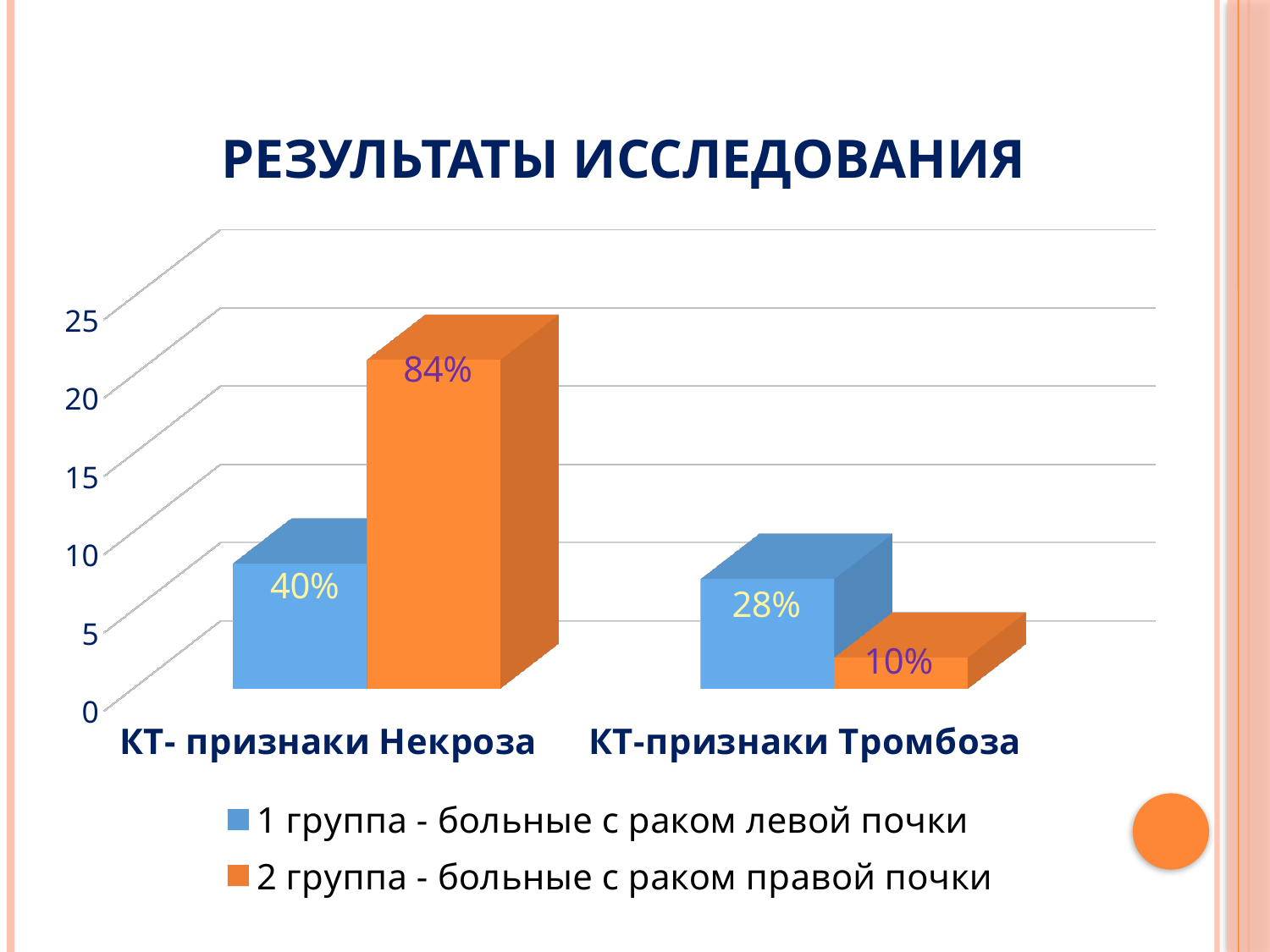
What is the difference between the data labels of group 1 and group 2 in the category 'КТ-признаки Тромбоза'? 18% In the category 'КТ-признаки Тромбоза', which group has the larger value? 1 группа - больные с раком левой почки How many series does the legend list? 2 What type of chart is shown on the slide? Bar chart Which bar has the lowest data label on the chart? Group 2 (больные с раком правой почки), КТ-признаки Тромбоза What is the data label for group 1 in the category 'КТ-признаки Тромбоза'? 28% Is the bar for group 2 in 'КТ- признаки Некроза' greater or less than 15 on the vertical axis? greater What is the data label for group 1 (больные с раком левой почки) in the category 'КТ- признаки Некроза'? 40% Which bar has the highest data label on the chart? Group 2 (больные с раком правой почки), КТ- признаки Некроза What is the data label for group 2 (больные с раком правой почки) in the category 'КТ- признаки Некроза'? 84% What is the data label for group 2 in the category 'КТ-признаки Тромбоза'? 10% What is the difference between the data labels of group 2 and group 1 in the category 'КТ- признаки Некроза'? 44%